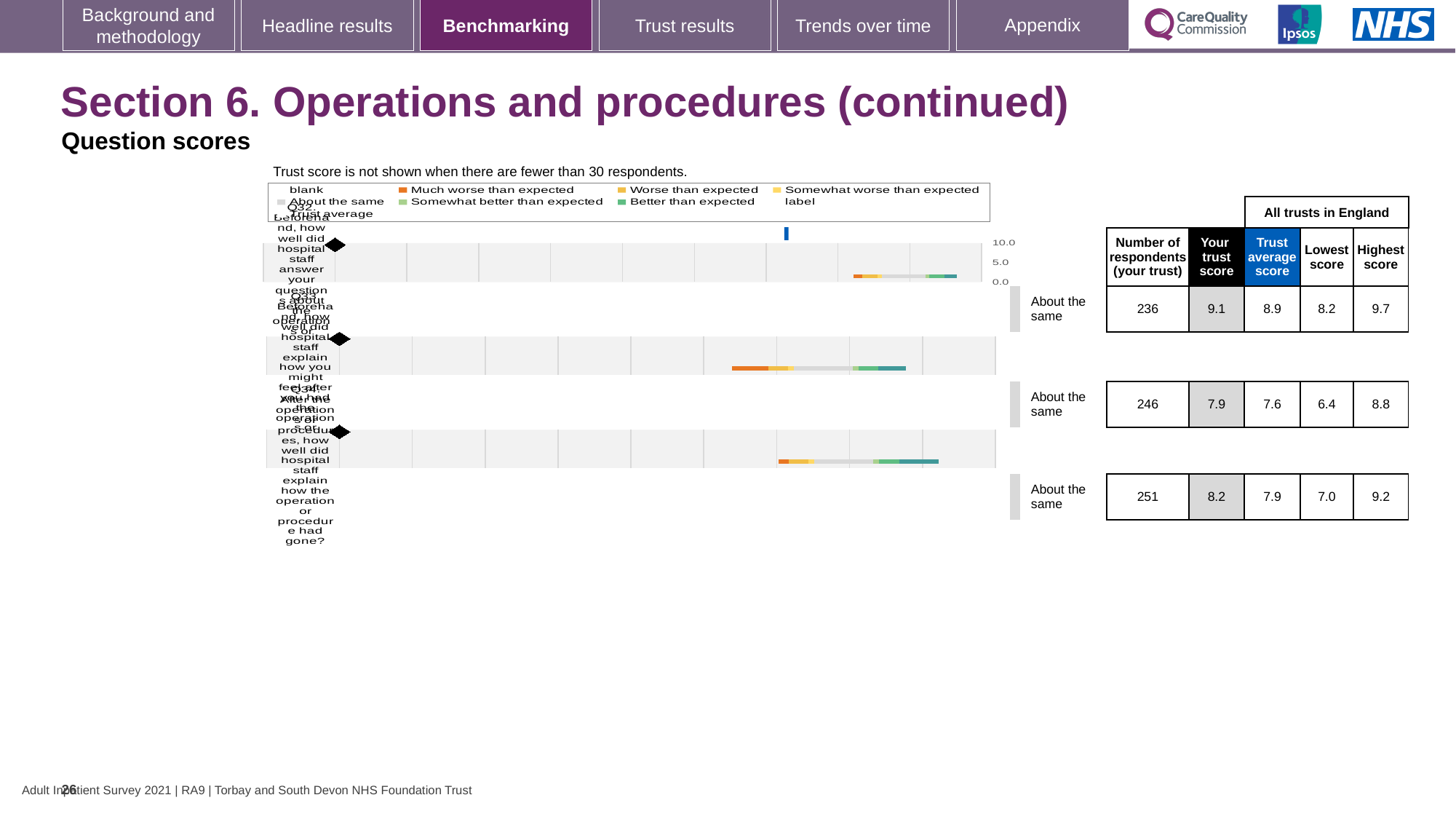
How many question charts are shown on the slide? 3 For the first (top) chart, what is the highest score among all trusts in England? 9.7 For the third (bottom) chart, what is the trust average score? 7.9 Which of the three charts has the lowest 'Lowest score' among all trusts in England? The second (middle) chart For the second (middle) chart, what is the number of respondents for your trust? 246 For the first (top) chart, what is the difference between your trust score and the trust average score? 0.2 What benchmark category label is shown next to each of the three charts? About the same For the first (top) chart, what is the 'Your trust score' value? 9.1 What kind of chart is used to show the benchmarking results on this slide? Bar chart For the second (middle) chart, which is larger: your trust score or the trust average score? Your trust score Which of the three charts has the highest 'Your trust score'? The first (top) chart For the second (middle) chart, what is the lowest score among all trusts in England? 6.4